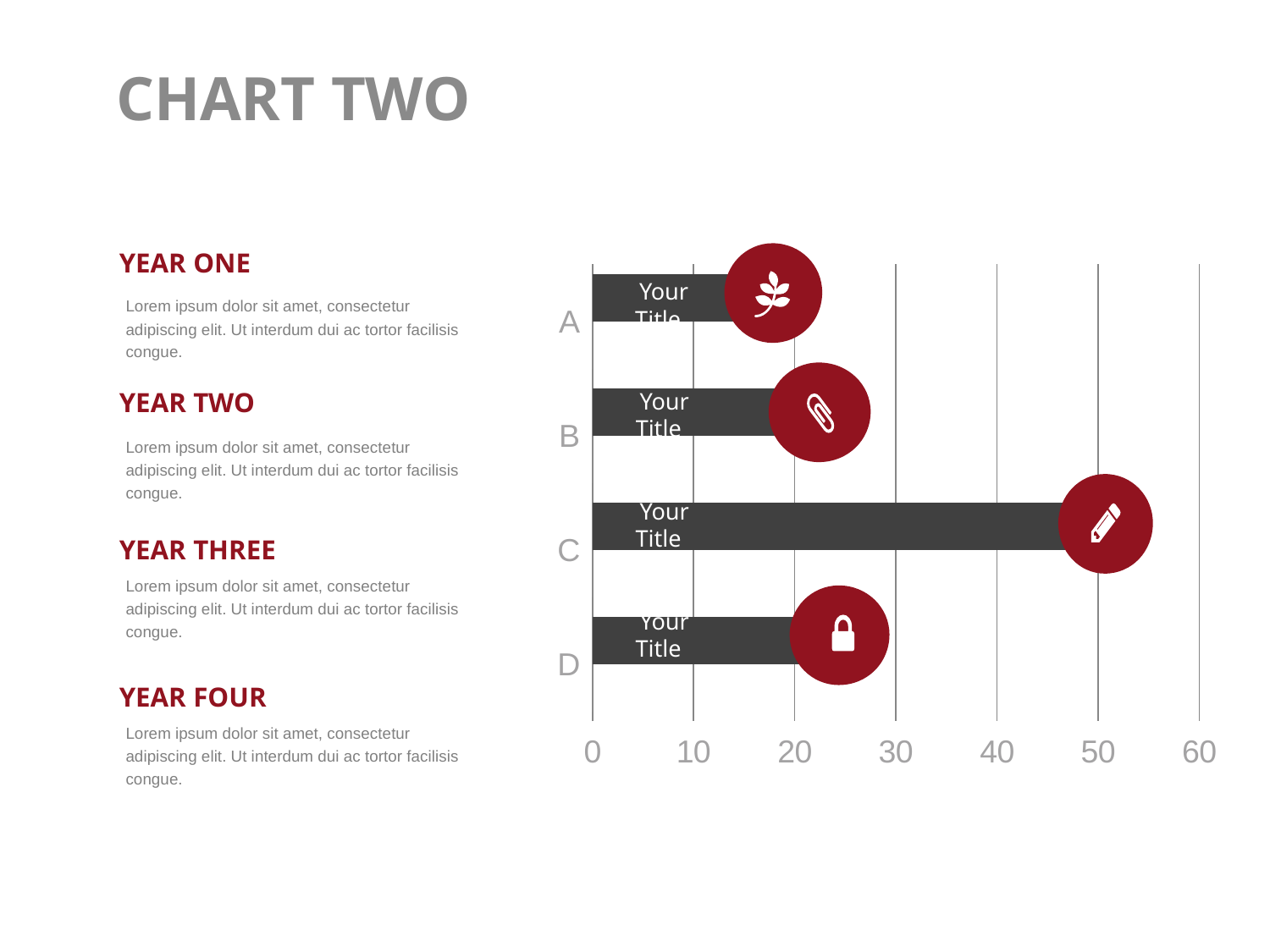
Which has the larger value, A or B? B What kind of chart is shown on the slide? bar chart Is the value for B greater or less than 10? greater Which category has the highest value? C Which category has the lowest value? A What is the highest value shown on the chart's horizontal axis? 60 What is the title of the slide containing the chart? CHART TWO Which has the larger value, C or D? C Is the value for A greater or less than 20? less Is the value for D greater or less than 30? less How many categories does the chart show? 4